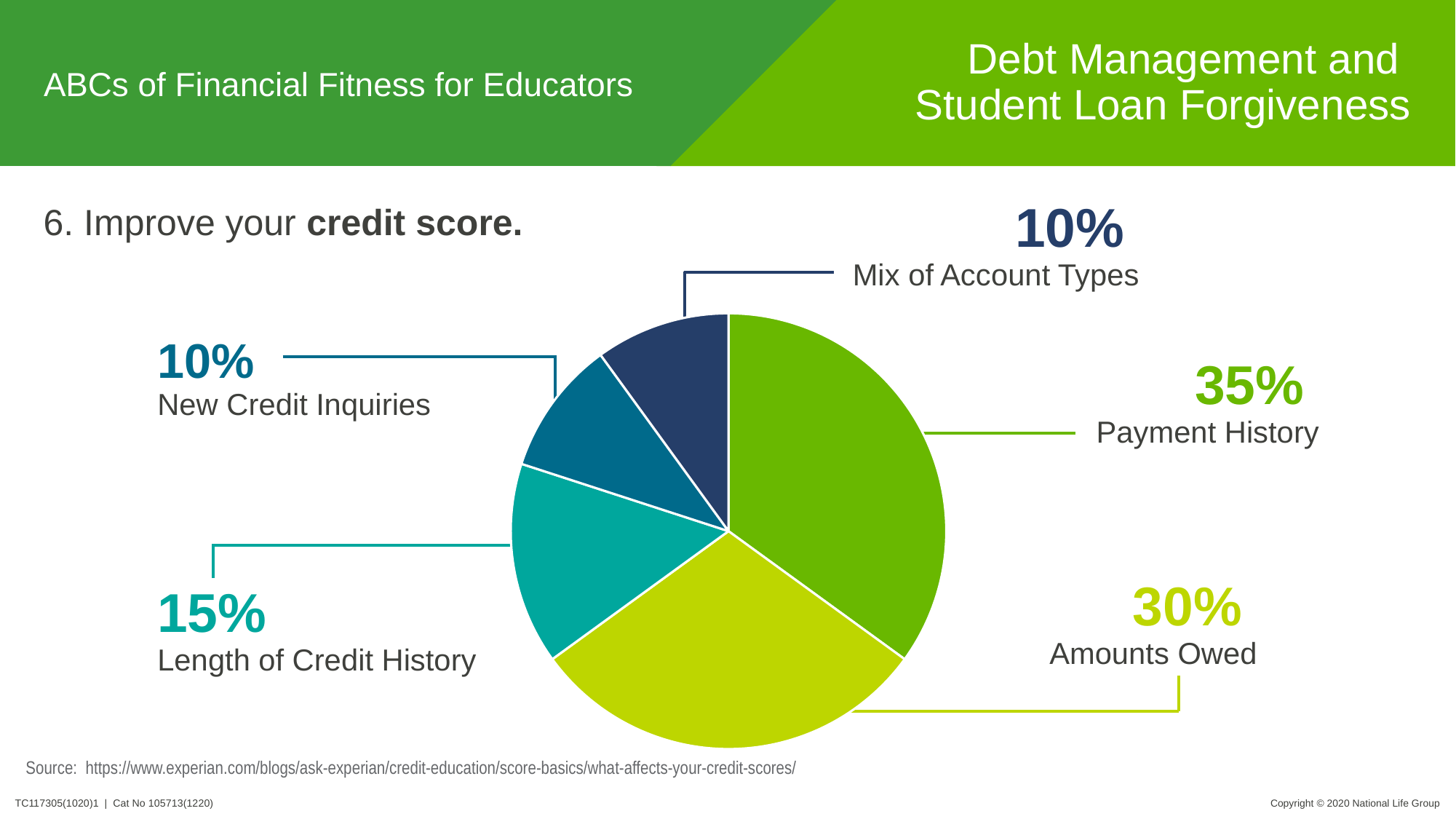
What kind of chart is shown on the slide? Pie chart What share of the pie chart is Length of Credit History? 15% How many categories share the smallest value of 10% in the pie chart? 2 What share of the pie chart is Payment History? 35% How many slices does the pie chart have? 5 What share of the pie chart is Amounts Owed? 30% What share of the pie chart is New Credit Inquiries? 10% What is the difference between the Amounts Owed and Length of Credit History shares? 15% What is the combined share of Payment History and Amounts Owed? 65% What is the difference between the Payment History and Amounts Owed shares? 5% Which is larger, the share for Length of Credit History or the share for Mix of Account Types? Length of Credit History Which category has the largest slice of the pie chart? Payment History